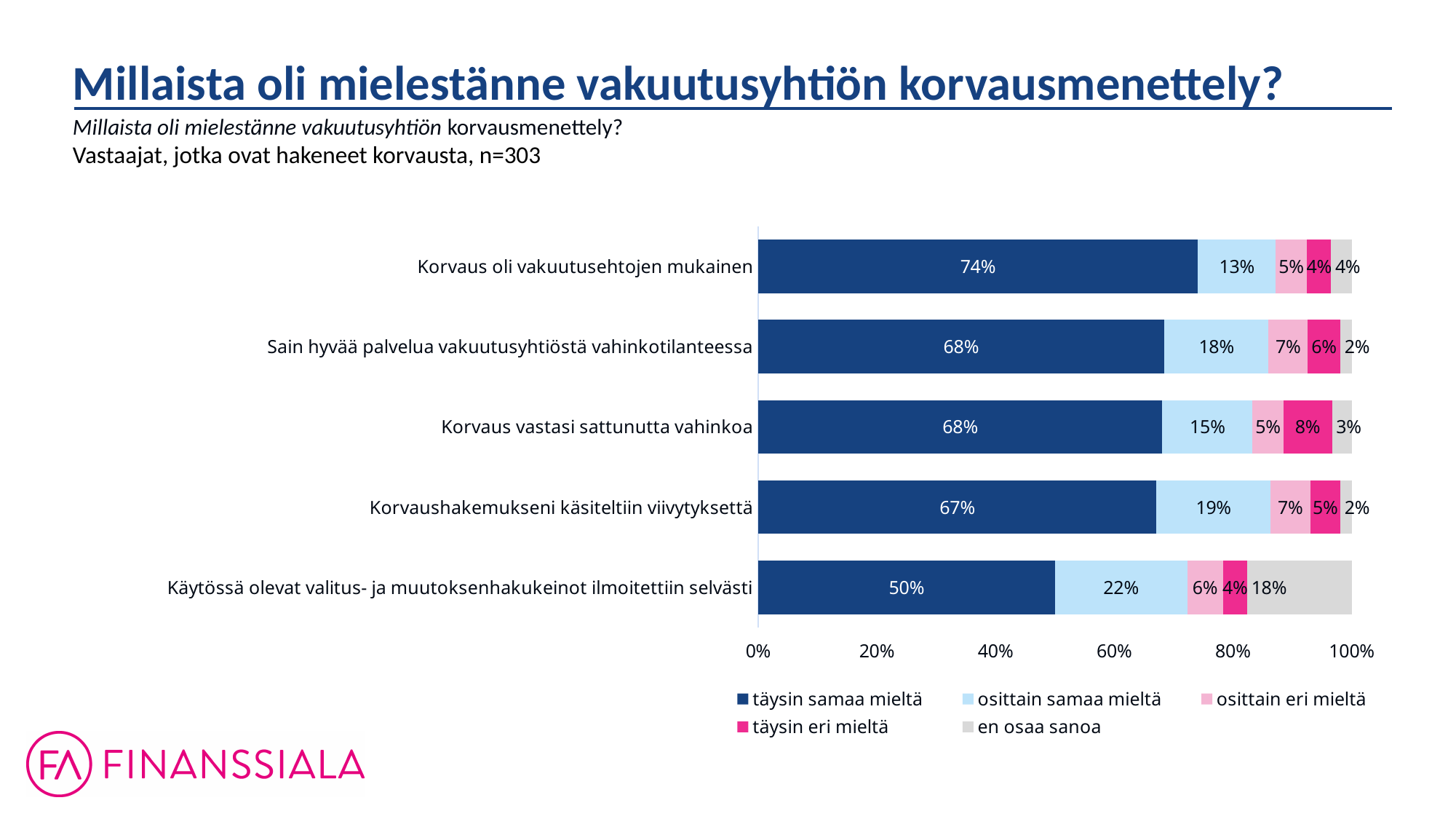
Which is larger: the 'täysin eri mieltä' value for 'Korvaus vastasi sattunutta vahinkoa' or for 'Sain hyvää palvelua vakuutusyhtiöstä vahinkotilanteessa'? Korvaus vastasi sattunutta vahinkoa What is the total of the stacked bar for 'Sain hyvää palvelua vakuutusyhtiöstä vahinkotilanteessa'? 101% What is the 'en osaa sanoa' value for 'Käytössä olevat valitus- ja muutoksenhakukeinot ilmoitettiin selvästi'? 18% Which statement has the lowest 'täysin samaa mieltä' share? Käytössä olevat valitus- ja muutoksenhakukeinot ilmoitettiin selvästi Which statement has the highest 'täysin samaa mieltä' share? Korvaus oli vakuutusehtojen mukainen What is the sample size (n) stated on the slide? n=303 What is the difference between the 'täysin samaa mieltä' values for 'Korvaus oli vakuutusehtojen mukainen' and 'Käytössä olevat valitus- ja muutoksenhakukeinot ilmoitettiin selvästi'? 24% How many series does the legend list? 5 What is the 'täysin samaa mieltä' value for 'Korvaus oli vakuutusehtojen mukainen'? 74% What is the 'osittain samaa mieltä' value for 'Korvaushakemukseni käsiteltiin viivytyksettä'? 19% How many statements (categories) are plotted in the chart? 5 What kind of chart is shown on the slide? Stacked bar chart